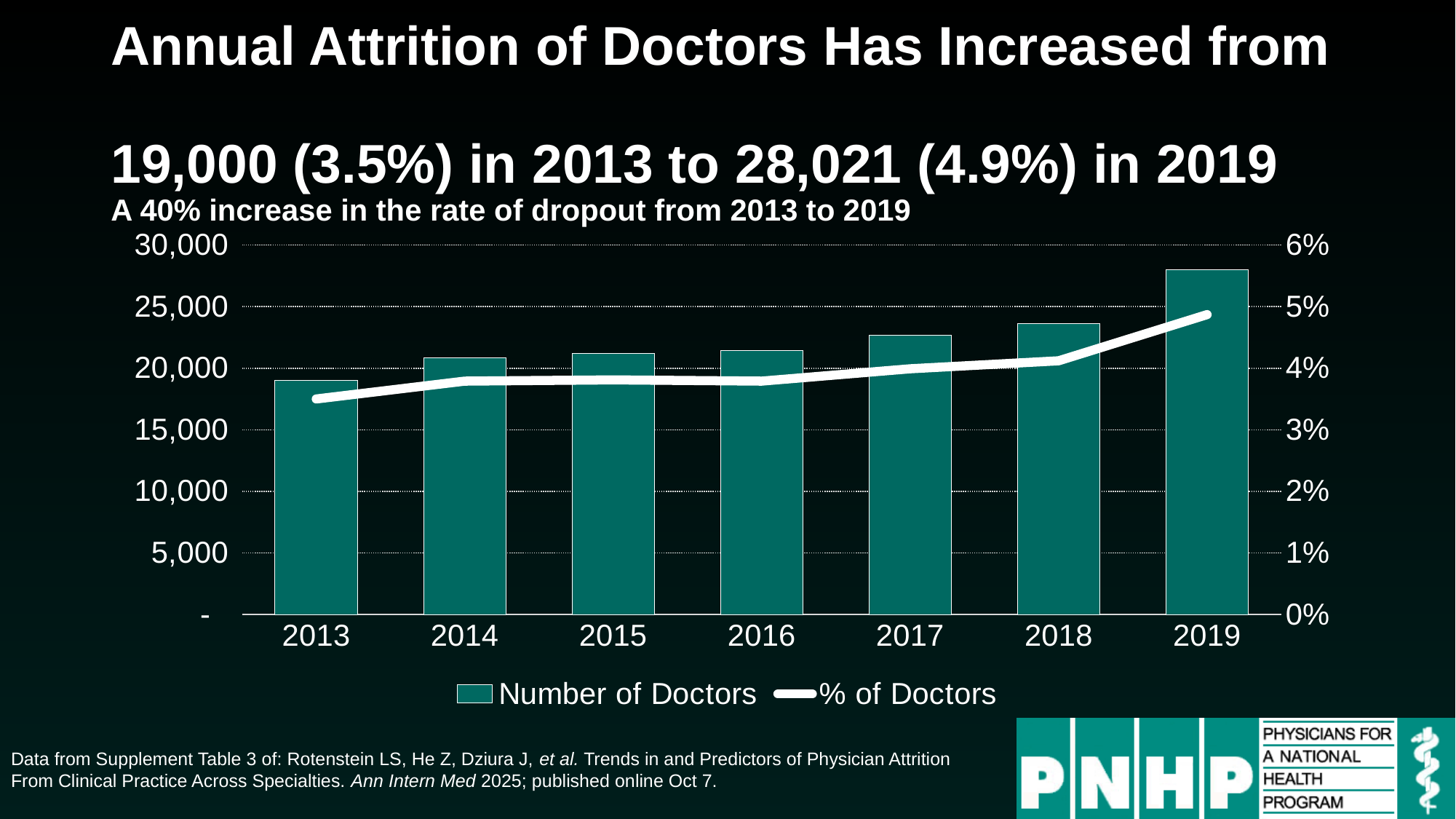
How many series does the chart's legend list? 2 How many years are shown along the x axis of the chart? 7 What was the number of doctors leaving in 2013? 19,000 By how much did the number of doctors leaving increase from 2013 to 2019? 9,021 Is the % of doctors for 2018 greater or less than 5%? less Which year has the lowest number of doctors leaving? 2013 What kind of chart is shown on the slide? A bar chart with a line Does the % of doctors line rise or fall from 2013 to 2019? Rises Is the number of doctors for 2016 greater or less than 20,000? greater What was the attrition rate (% of doctors) in 2019? 4.9% Which year has the highest number of doctors leaving? 2019 Which year has the larger number of doctors, 2015 or 2018? 2018